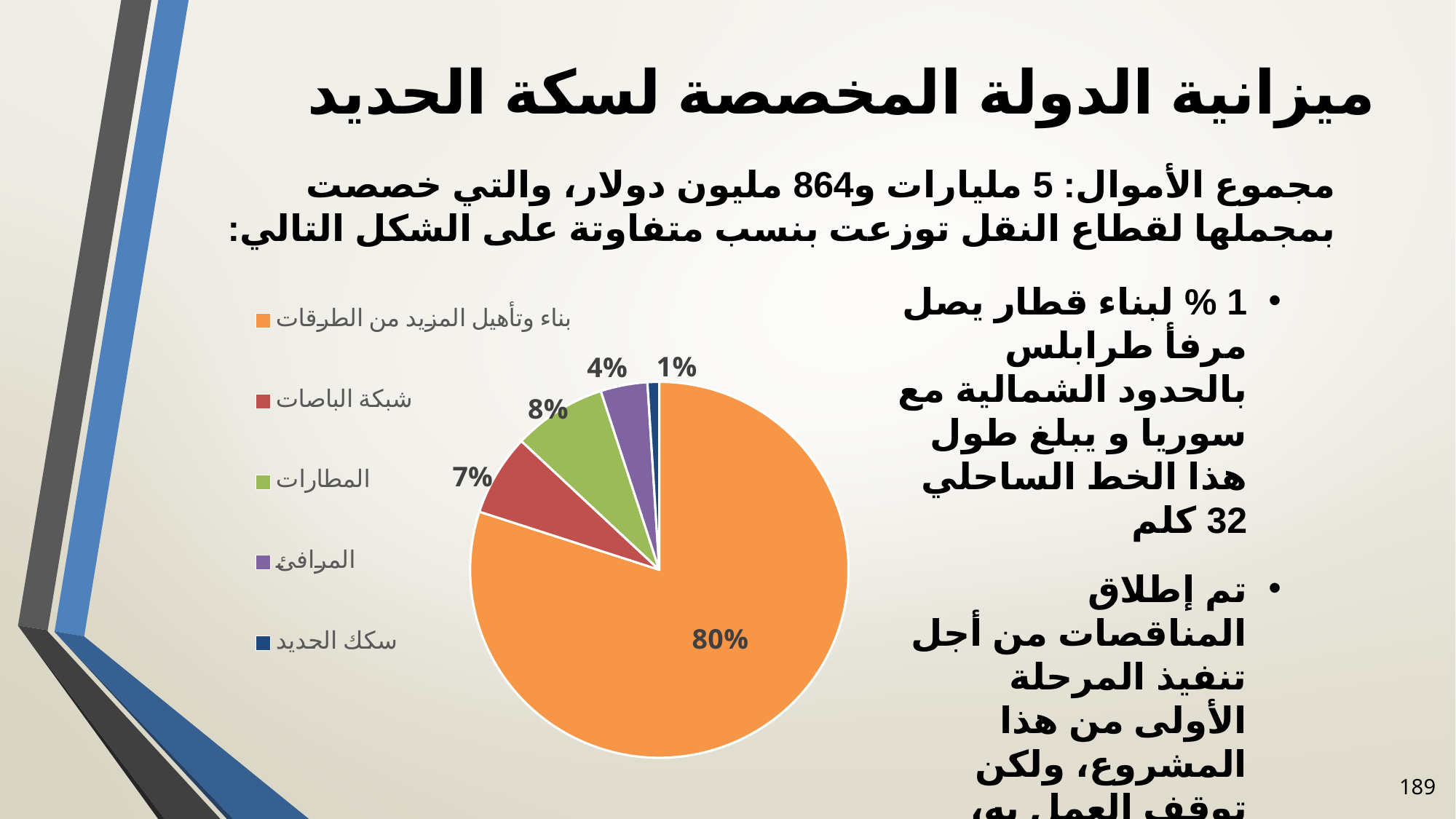
What is the difference between the shares of المطارات and شبكة الباصات? 1% Which is larger, the share for المرافئ or the share for سكك الحديد? المرافئ What share of the pie does المرافئ have? 4% What share of the pie does بناء وتأهيل المزيد من الطرقات have? 80% Which category has the smallest slice of the pie? سكك الحديد What kind of chart is shown on the slide? pie chart What share of the pie does شبكة الباصات have? 7% Which category has the largest slice of the pie? بناء وتأهيل المزيد من الطرقات What colour is the slice for بناء وتأهيل المزيد من الطرقات? orange What share of the pie does سكك الحديد have? 1% How many categories does the legend of the pie chart list? 5 What share of the pie does المطارات have? 8%